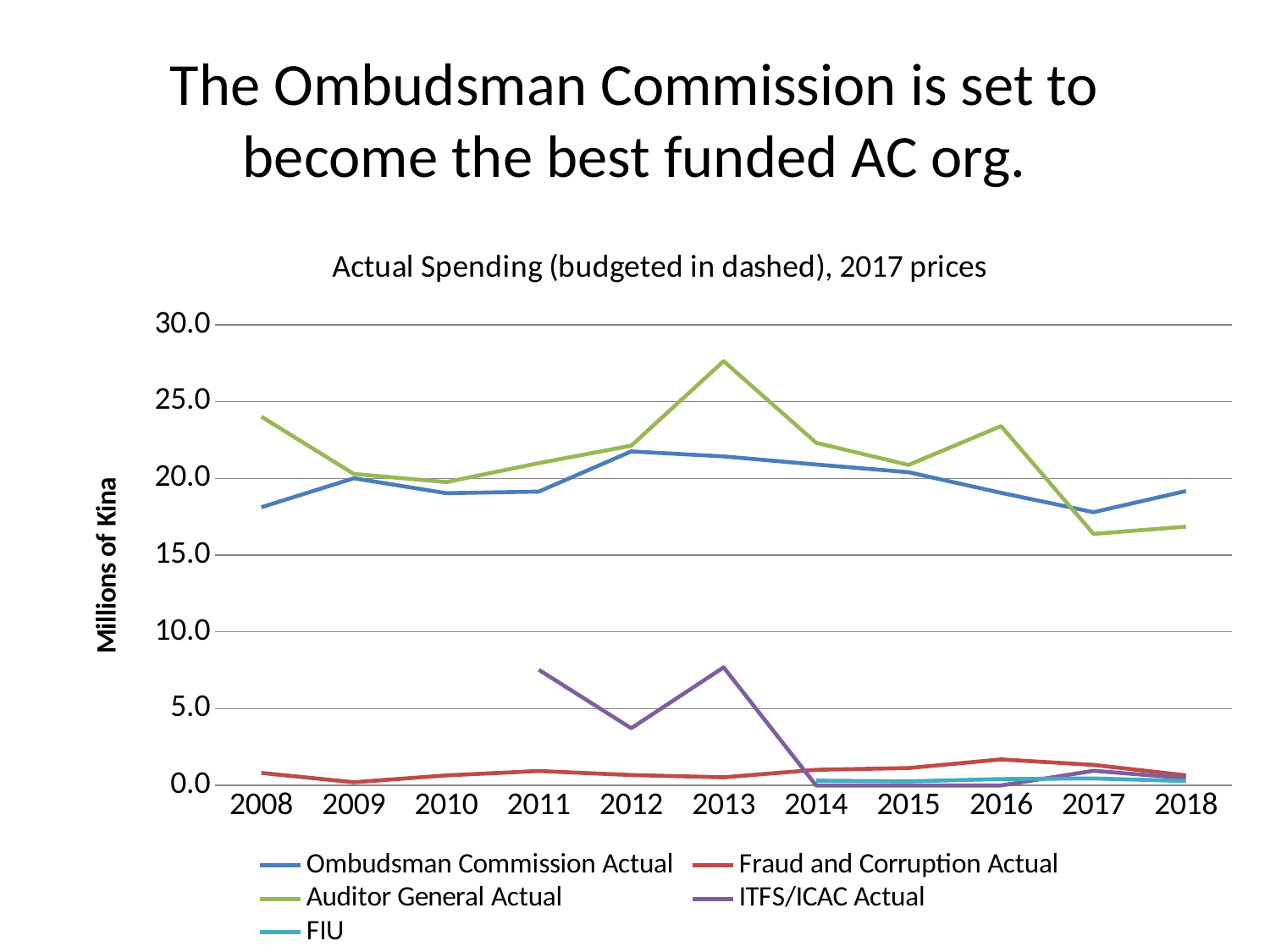
Which series has the highest value in 2013? Auditor General Actual In 2018, which is higher: Ombudsman Commission Actual or Auditor General Actual? Ombudsman Commission Actual Does the Auditor General Actual line rise or fall from 2016 to 2017? fall Is the value for Ombudsman Commission Actual in 2008 greater or less than 20.0? less Is the value for Auditor General Actual in 2017 greater or less than 20.0? less In 2008, which is higher: Ombudsman Commission Actual or Auditor General Actual? Auditor General Actual Is the value for Auditor General Actual in 2013 greater or less than 25.0? greater What kind of chart is shown on the slide? line chart How many years are shown on the x axis? 11 How many series does the legend list? 5 In which year does Auditor General Actual reach its highest value? 2013